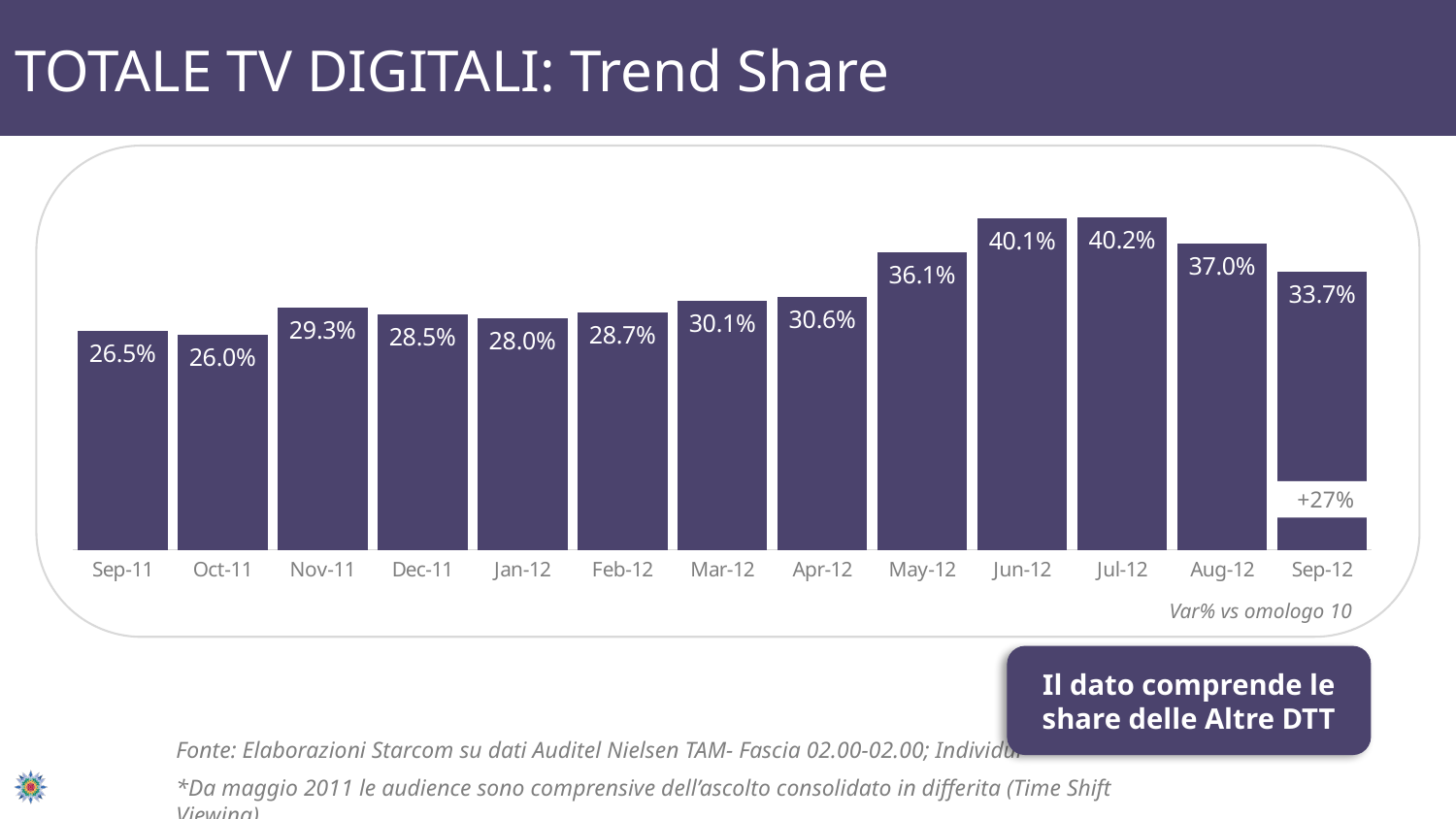
What is the share value for Sep-12? 33.7% What is the Var% vs omologo 10 shown for Sep-12? +27% What kind of chart is shown on the slide? Bar chart What is the difference in percentage points between the May-12 value and the Apr-12 value? 5.5 Which month has the lowest share value? Oct-11 What is the share value for Nov-11? 29.3% How many months are shown on the x axis? 13 What is the share value for May-12? 36.1% Which is larger, the value for Aug-12 or the value for Sep-12? Aug-12 Do the values generally rise or fall from Sep-11 to Jul-12? Rise What is the difference in percentage points between the Sep-12 value and the Sep-11 value? 7.2 Which month has the highest share value? Jul-12